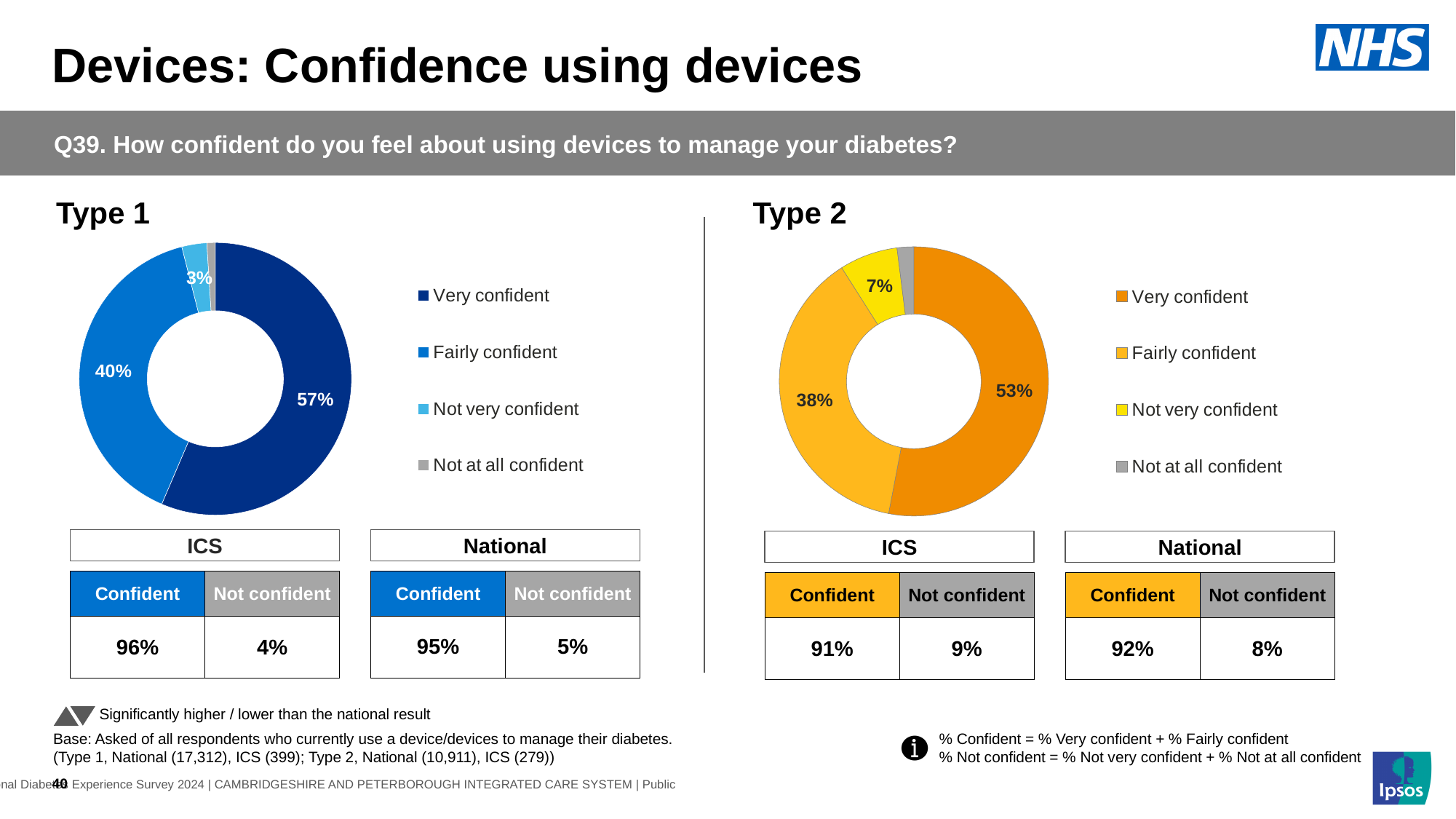
In the Type 1 chart, what percentage of respondents are very confident? 57% In the Type 1 chart, what share of the pie is not very confident? 3% What kind of chart is used for Type 1? Doughnut (pie) chart In the Type 1 chart, is the share for fairly confident greater or less than 50%? less How many categories does the legend of the Type 2 chart list? 4 Which is larger: the very confident share in the Type 1 chart or the very confident share in the Type 2 chart? Type 1 In the Type 2 chart, what percentage of respondents are fairly confident? 38% In the Type 1 chart, which category has the largest share? Very confident In the Type 1 chart, what is the difference between the very confident and fairly confident shares? 17 percentage points In the Type 2 chart, which category has the smallest share? Not at all confident In the Type 2 chart, what percentage of respondents are not very confident? 7% What colour represents the 'Not at all confident' category in both charts? Grey